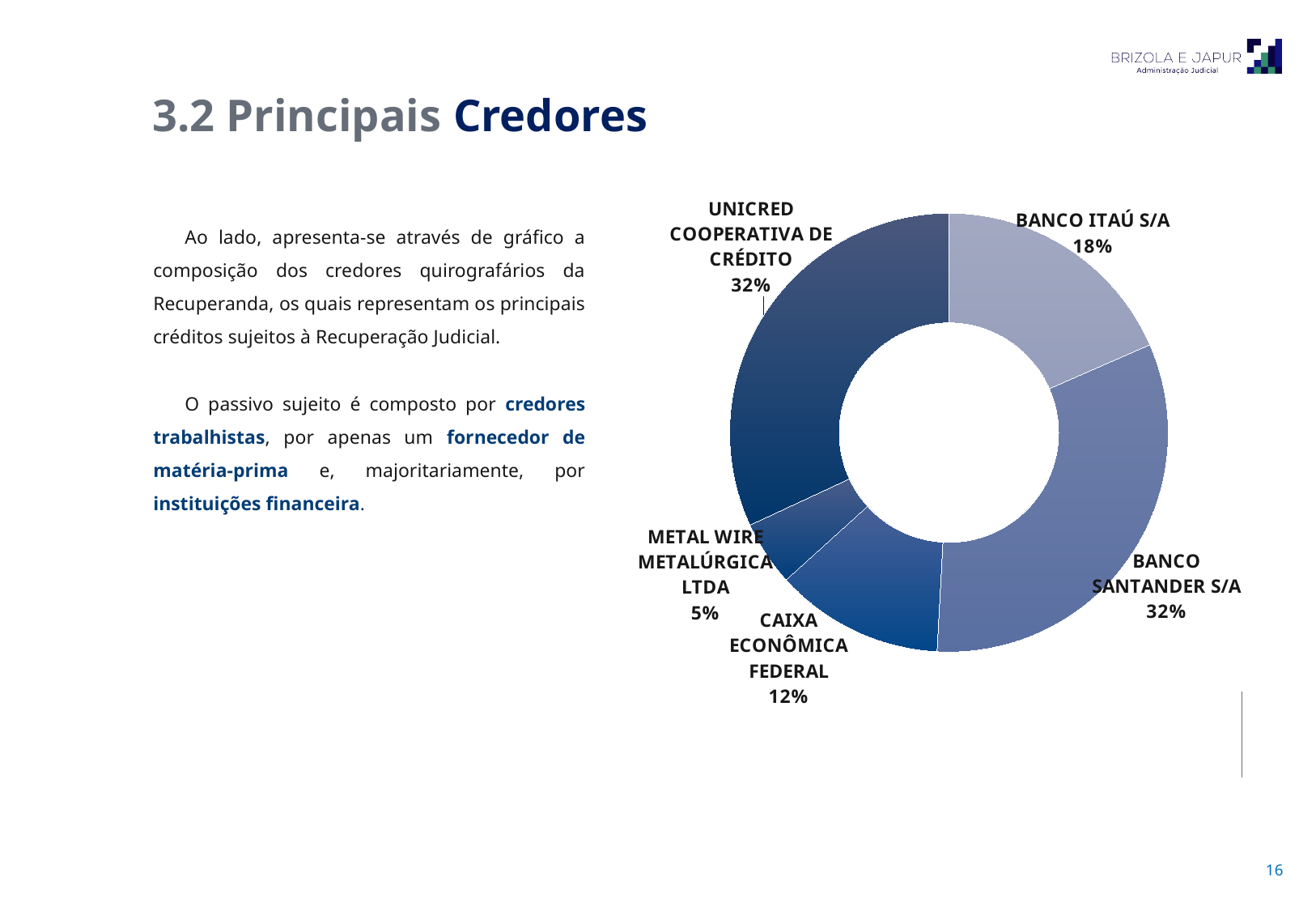
Which creditor has the smallest slice of the chart? METAL WIRE METALÚRGICA LTDA Which is larger, the slice for BANCO ITAÚ S/A or the slice for CAIXA ECONÔMICA FEDERAL? BANCO ITAÚ S/A What share of the chart does BANCO ITAÚ S/A represent? 18% How many creditors are shown in the chart? 5 What percentage is shown for UNICRED COOPERATIVA DE CRÉDITO? 32% What percentage is shown for CAIXA ECONÔMICA FEDERAL? 12% What percentage is shown for METAL WIRE METALÚRGICA LTDA? 5% What is the difference in percentage points between BANCO SANTANDER S/A and BANCO ITAÚ S/A? 14 percentage points What kind of chart is shown on the slide? Pie (donut) chart What is the combined share of BANCO SANTANDER S/A and UNICRED COOPERATIVA DE CRÉDITO? 64% What percentage is shown for BANCO SANTANDER S/A? 32% What is the difference in percentage points between CAIXA ECONÔMICA FEDERAL and METAL WIRE METALÚRGICA LTDA? 7 percentage points